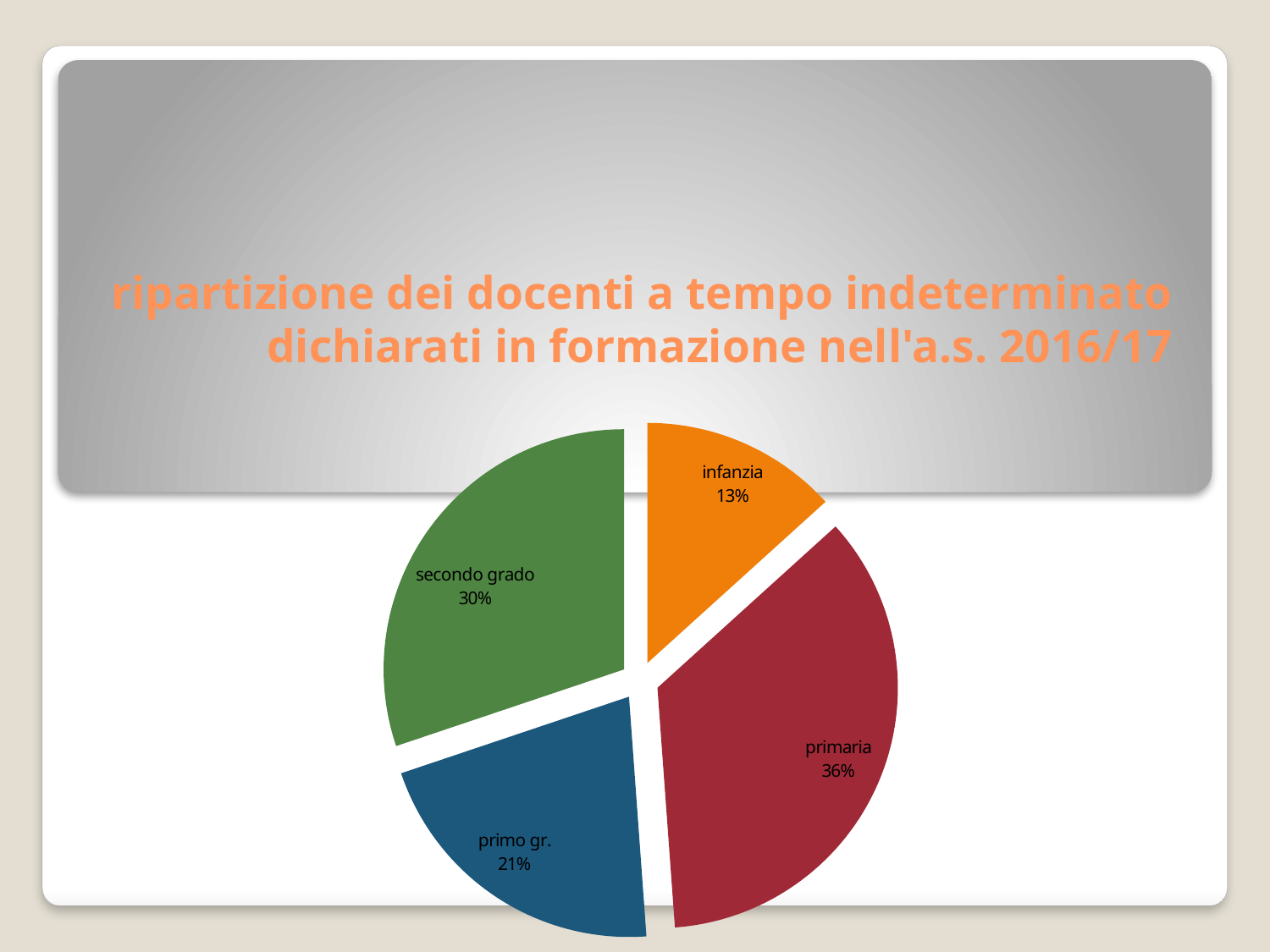
What is the value shown for "primo gr."? 21% How many slices does the pie chart have? 4 Which is larger, the slice for "secondo grado" or the slice for "primo gr."? secondo grado What is the value shown for "secondo grado"? 30% What share of the pie does the "infanzia" slice represent? 13% What colour is the "primaria" slice? dark red What is the difference in percentage points between "secondo grado" and "primo gr."? 9 Which category has the largest slice of the pie? primaria What share of the pie does the "primaria" slice represent? 36% What is the difference in percentage points between "primaria" and "infanzia"? 23 What kind of chart is shown on the slide? pie chart Which category has the smallest slice of the pie? infanzia